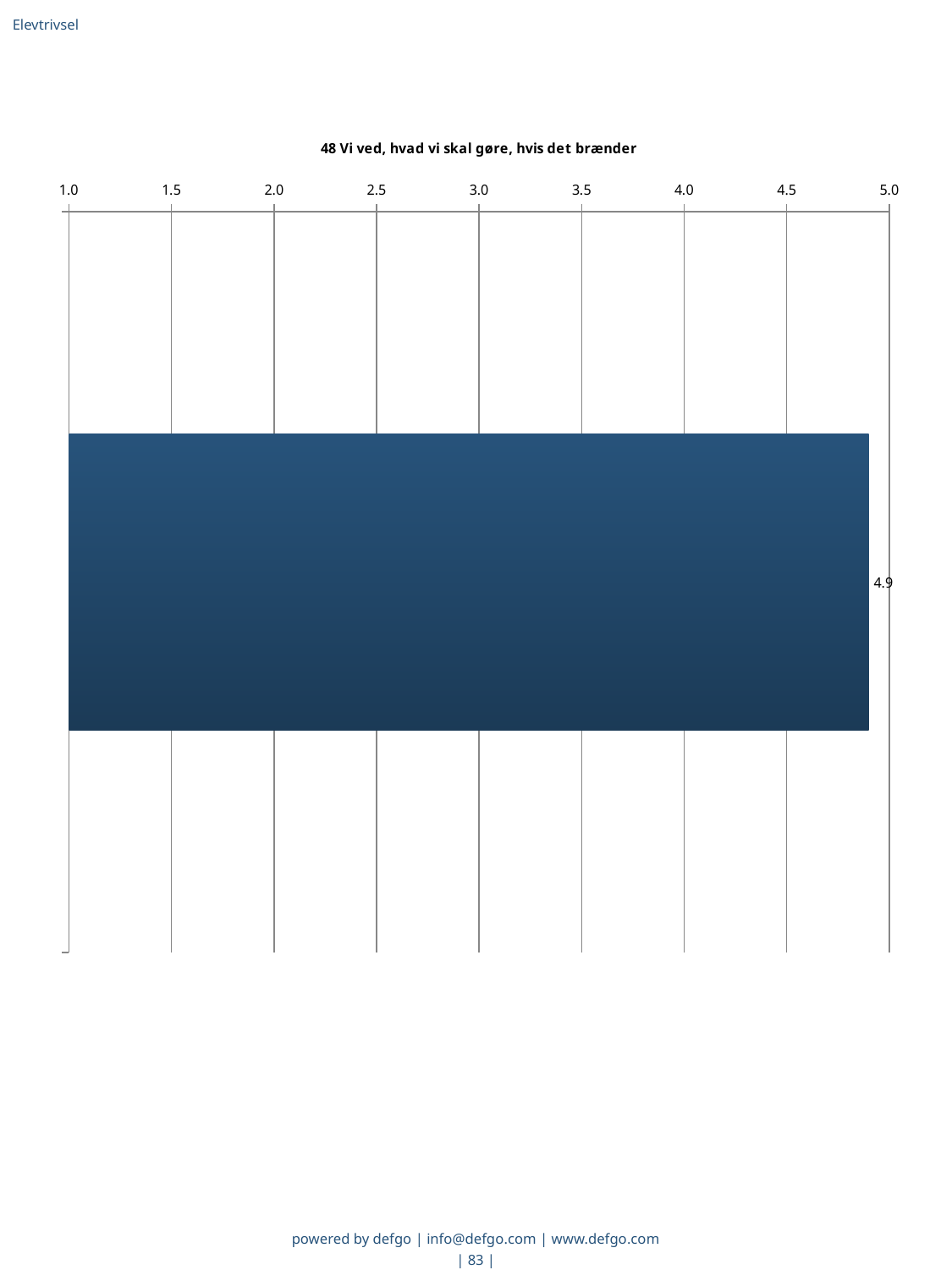
What kind of chart is shown on the slide? bar chart Is the value of the bar greater or less than 4.5? greater What is the value shown by the bar in the chart titled "48 Vi ved, hvad vi skal gøre, hvis det brænder"? 4.9 Is the value of the bar greater or less than 3.0? greater How many bars are plotted in the chart? 1 Is the bar's value greater or less than 5.0? less What is the highest value shown on the chart's axis? 5.0 What is the title of the chart? 48 Vi ved, hvad vi skal gøre, hvis det brænder